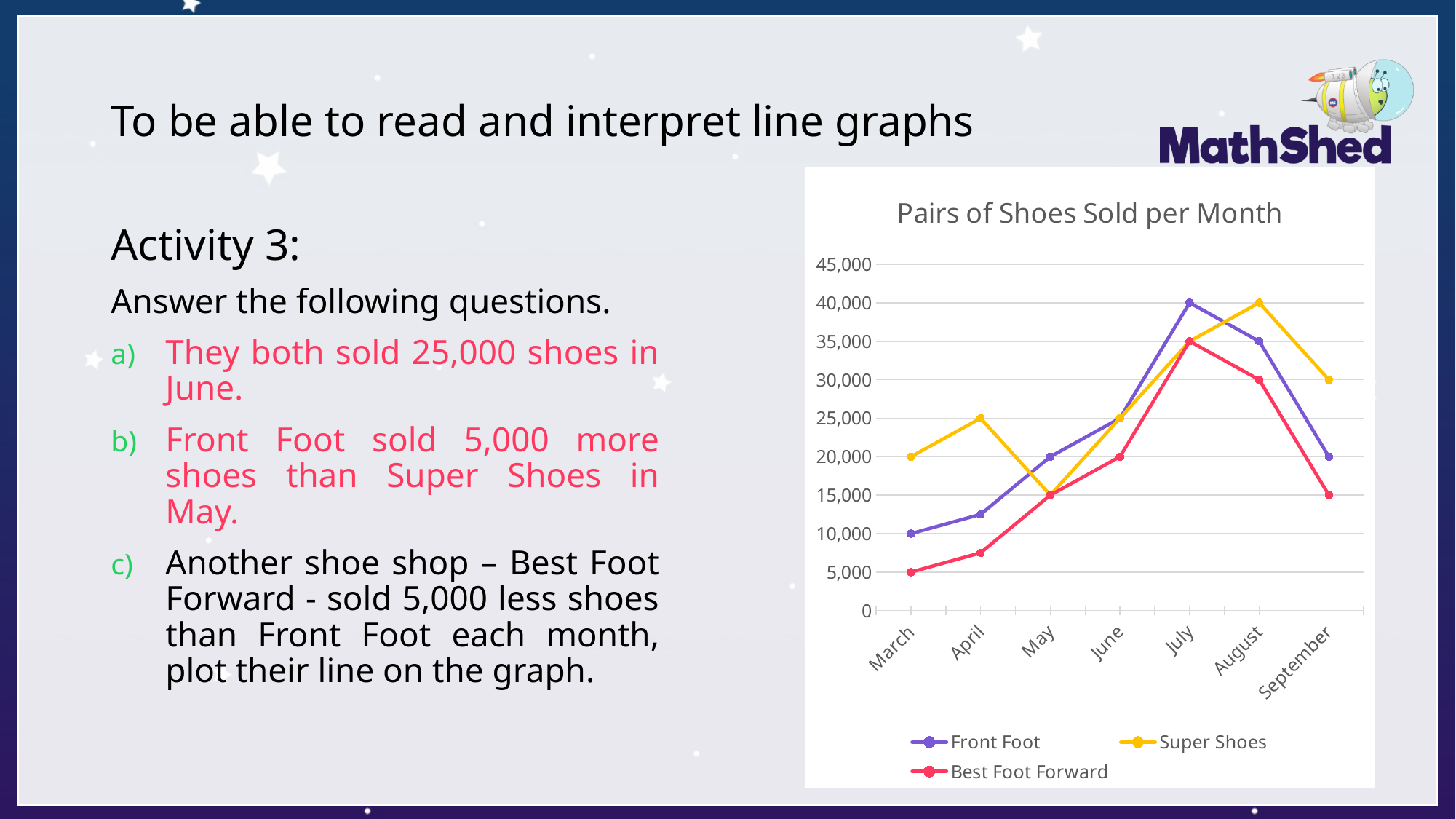
How many months are plotted along the x axis? 7 Is the value for Front Foot in April greater or less than 15,000? less In which month did Front Foot sell the most pairs of shoes? July What is the difference between Front Foot's and Super Shoes' sales in May? 5,000 What is the title of the chart? Pairs of Shoes Sold per Month How many pairs of shoes did Front Foot sell in July? 40,000 How many pairs of shoes did Super Shoes sell in August? 40,000 Which sold more pairs of shoes in September, Super Shoes or Front Foot? Super Shoes In which month did Super Shoes sell the fewest pairs of shoes? May What kind of chart is shown on the slide? line chart How many series does the legend list? 3 How many pairs of shoes did Best Foot Forward sell in March? 5,000